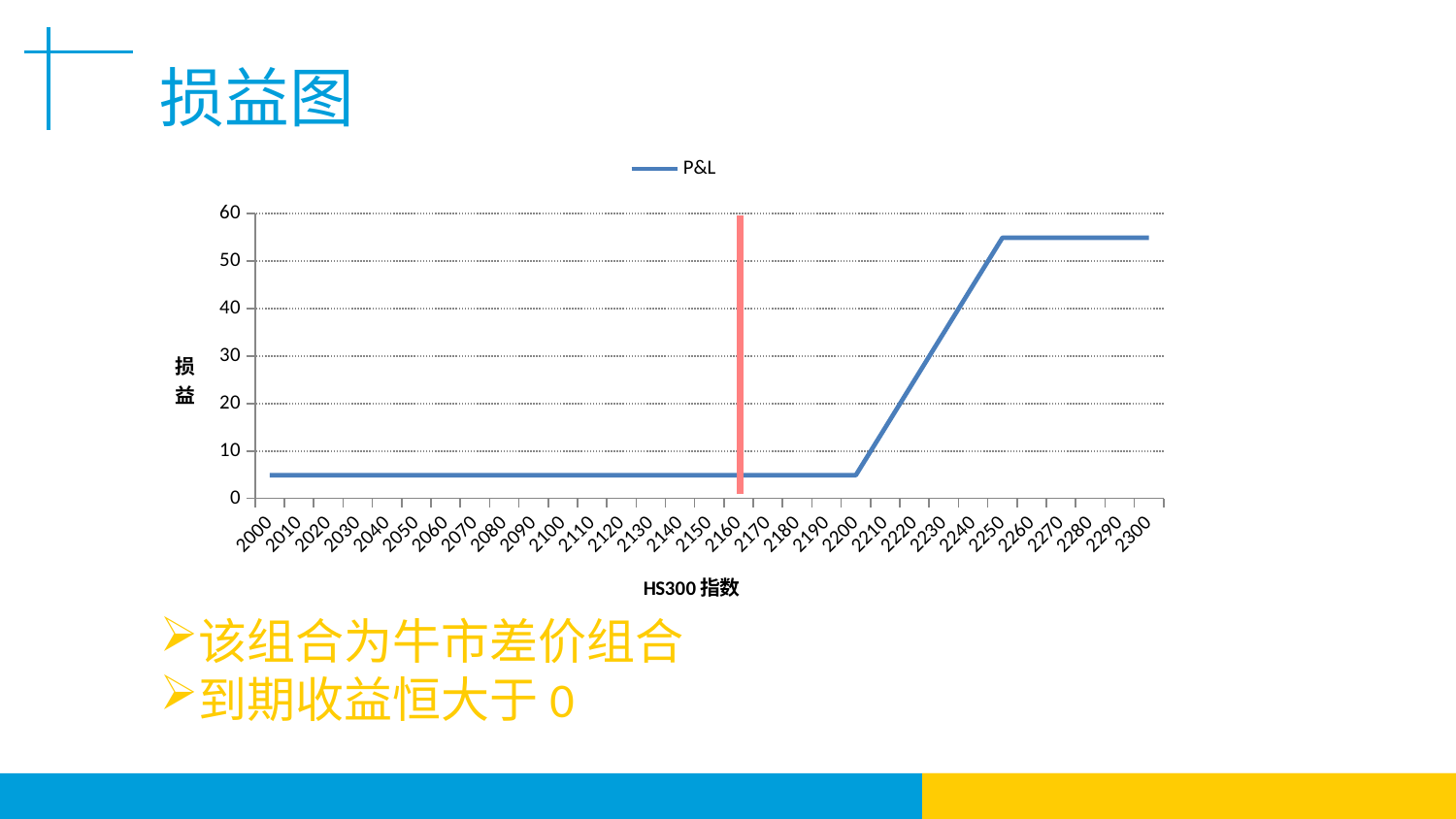
How many series does the legend list? 1 What is the name of the series shown in the legend? P&L Which has the larger P&L value, 2000 or 2300? 2300 What is the title of the x axis? HS300 指数 How many x-axis categories are plotted on the chart? 31 Is the P&L value at 2300 greater or less than 50? greater Does the P&L line rise or fall overall from left to right along the x axis? rise Is the P&L value at 2230 greater or less than 20? greater Is the P&L value at 2100 greater or less than 10? less What kind of chart is shown on the slide? line chart